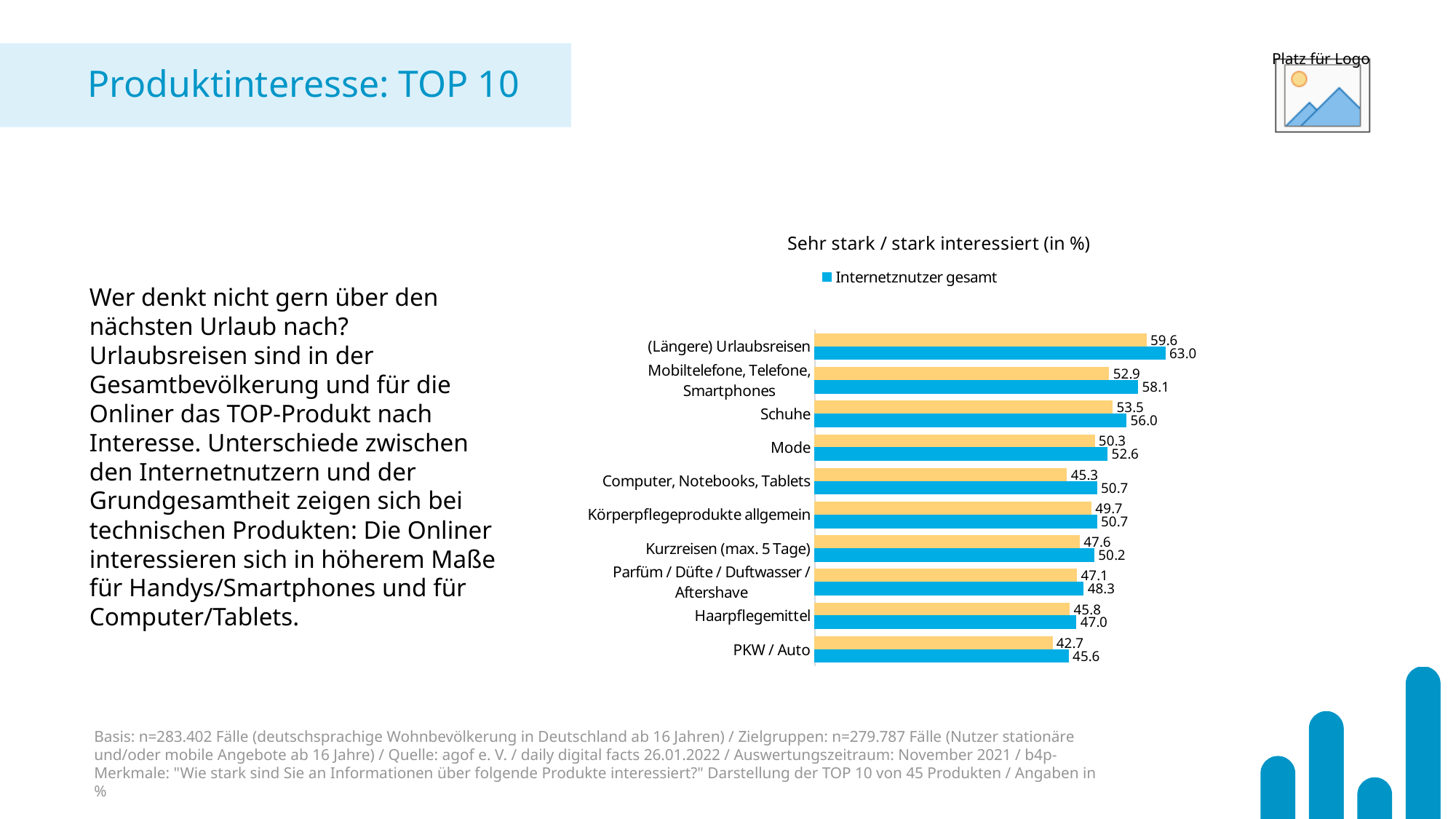
How many product categories are shown in the chart? 10 How many series does the chart legend list? 1 What is the difference between the Internetznutzer gesamt values for (Längere) Urlaubsreisen and PKW / Auto? 17.4 What is the Internetznutzer gesamt value for Schuhe? 56.0 What is the difference between the Internetznutzer gesamt values for Mobiltelefone, Telefone, Smartphones and Schuhe? 2.1 Which has the larger Internetznutzer gesamt value: Kurzreisen (max. 5 Tage) or Parfüm / Düfte / Duftwasser / Aftershave? Kurzreisen (max. 5 Tage) What is the Internetznutzer gesamt value for Mode? 52.6 What type of chart is shown on the slide? bar chart What is the Internetznutzer gesamt value for Haarpflegemittel? 47.0 What is the title of the chart? Sehr stark / stark interessiert (in %) Which category has the highest Internetznutzer gesamt value? (Längere) Urlaubsreisen Which category has the lowest Internetznutzer gesamt value? PKW / Auto